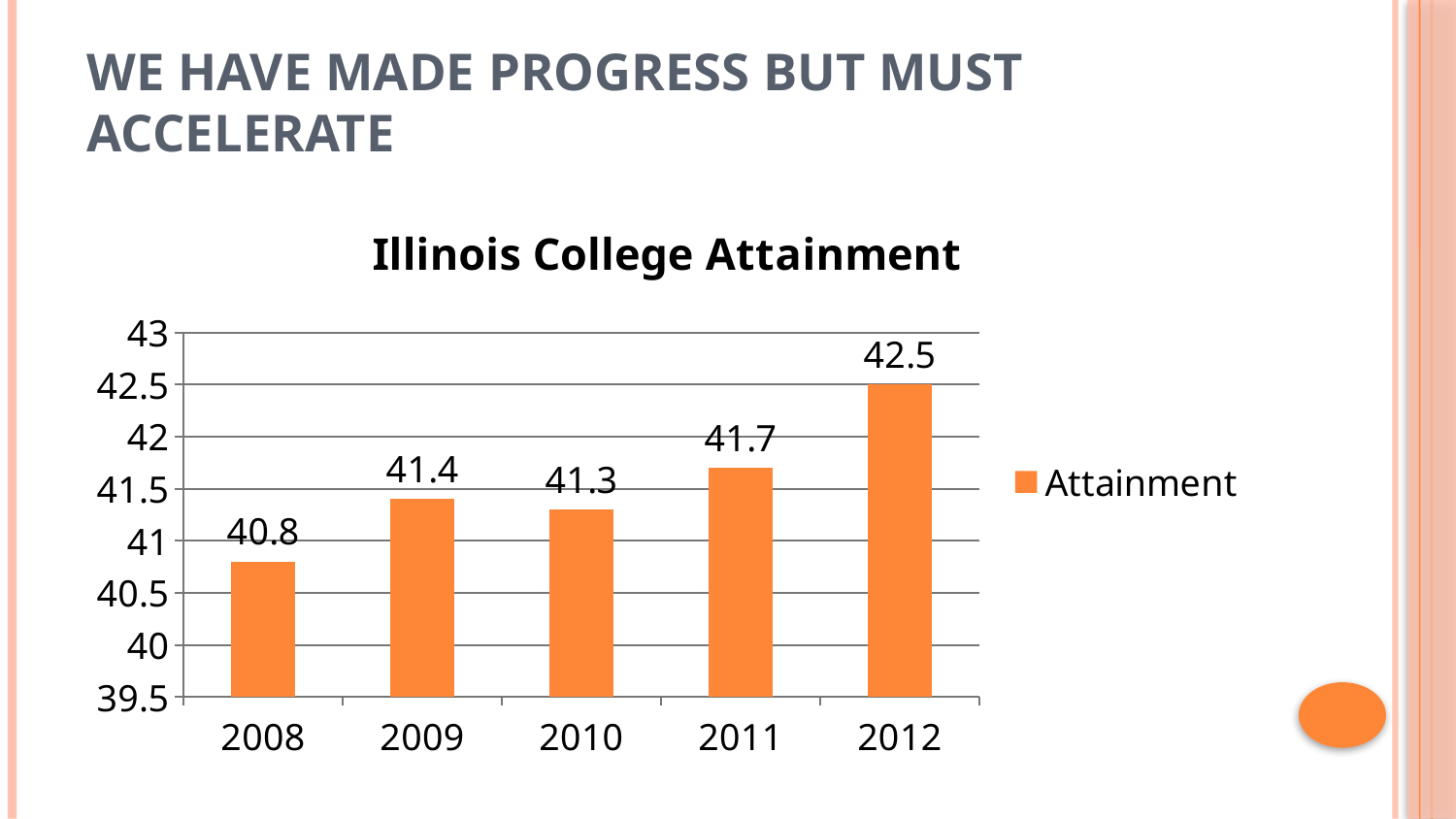
What is the title of the chart? Illinois College Attainment What is the attainment value for 2012? 42.5 How many years are shown on the x axis? 5 Which year has a larger attainment value, 2009 or 2011? 2011 What is the difference between the attainment values for 2011 and 2010? 0.4 Which year has the lowest attainment value? 2008 What kind of chart is shown on the slide? Bar chart What is the attainment value for 2008? 40.8 What is the difference between the attainment values for 2012 and 2008? 1.7 What is the attainment value for 2010? 41.3 How many series does the legend list? 1 Which year has the highest attainment value? 2012